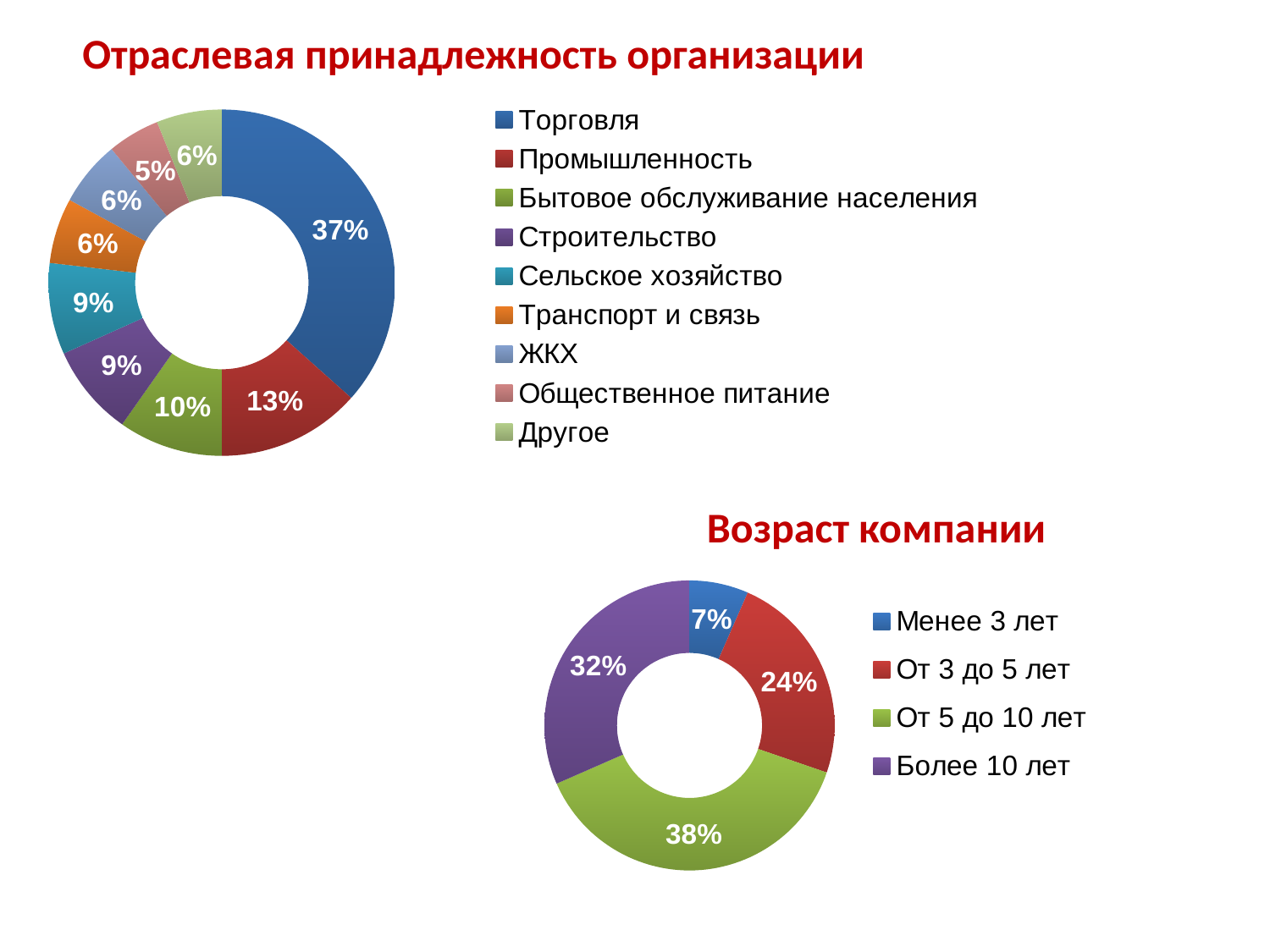
In the chart titled "Отраслевая принадлежность организации", what is the difference between the shares of Торговля and Промышленность? 24% What type of chart is used for "Возраст компании"? Doughnut (pie) chart In the chart titled "Отраслевая принадлежность организации", which category has the smallest share? Общественное питание In the chart titled "Отраслевая принадлежность организации", which category has the largest share? Торговля In the chart titled "Возраст компании", which category has the smallest share? Менее 3 лет In the chart titled "Отраслевая принадлежность организации", how many categories does the legend list? 9 In the chart titled "Возраст компании", what share do companies aged От 5 до 10 лет have? 38% In the chart titled "Возраст компании", what is the difference between the shares of От 5 до 10 лет and Более 10 лет? 6% In the chart titled "Возраст компании", how many categories are shown? 4 In the chart titled "Отраслевая принадлежность организации", which is larger: Бытовое обслуживание населения or Сельское хозяйство? Бытовое обслуживание населения In the chart titled "Отраслевая принадлежность организации", what share does Промышленность have? 13% In the chart titled "Отраслевая принадлежность организации", what share does Торговля have? 37%